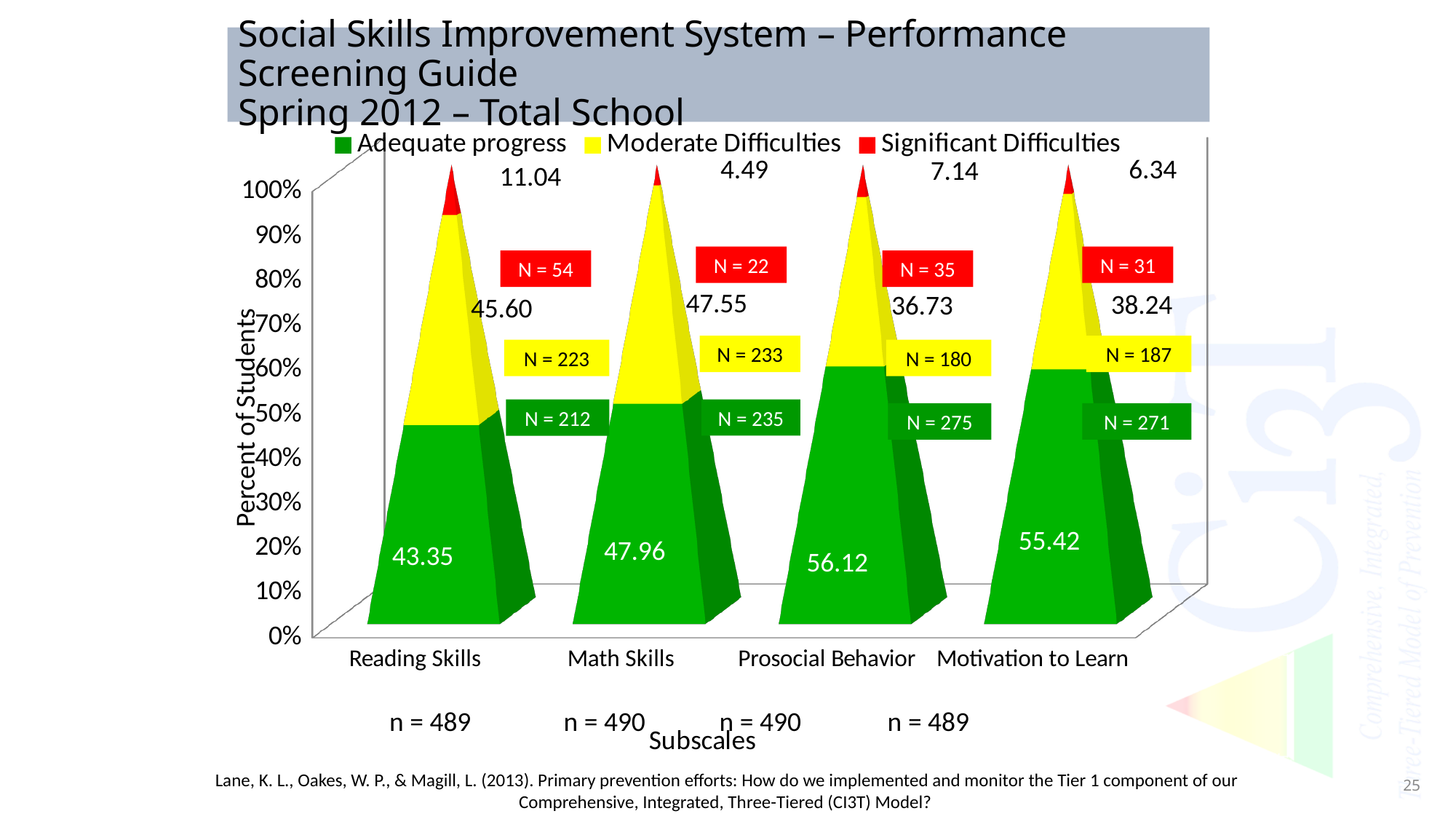
What is the Significant Difficulties value for Prosocial Behavior? 7.14 What kind of chart is shown on the slide? Stacked bar chart Which subscale has the lowest Significant Difficulties value? Math Skills What is the Adequate progress value for Reading Skills? 43.35 How many subscales are shown on the x axis? 4 Which is larger, the Moderate Difficulties value for Reading Skills or for Prosocial Behavior? Reading Skills What is the Moderate Difficulties value for Math Skills? 47.55 How many series does the legend list? 3 What is the Adequate progress value for Motivation to Learn? 55.42 What is the label of the y axis? Percent of Students Which subscale has the highest Adequate progress value? Prosocial Behavior What is the difference between the Significant Difficulties values for Reading Skills and Math Skills? 6.55